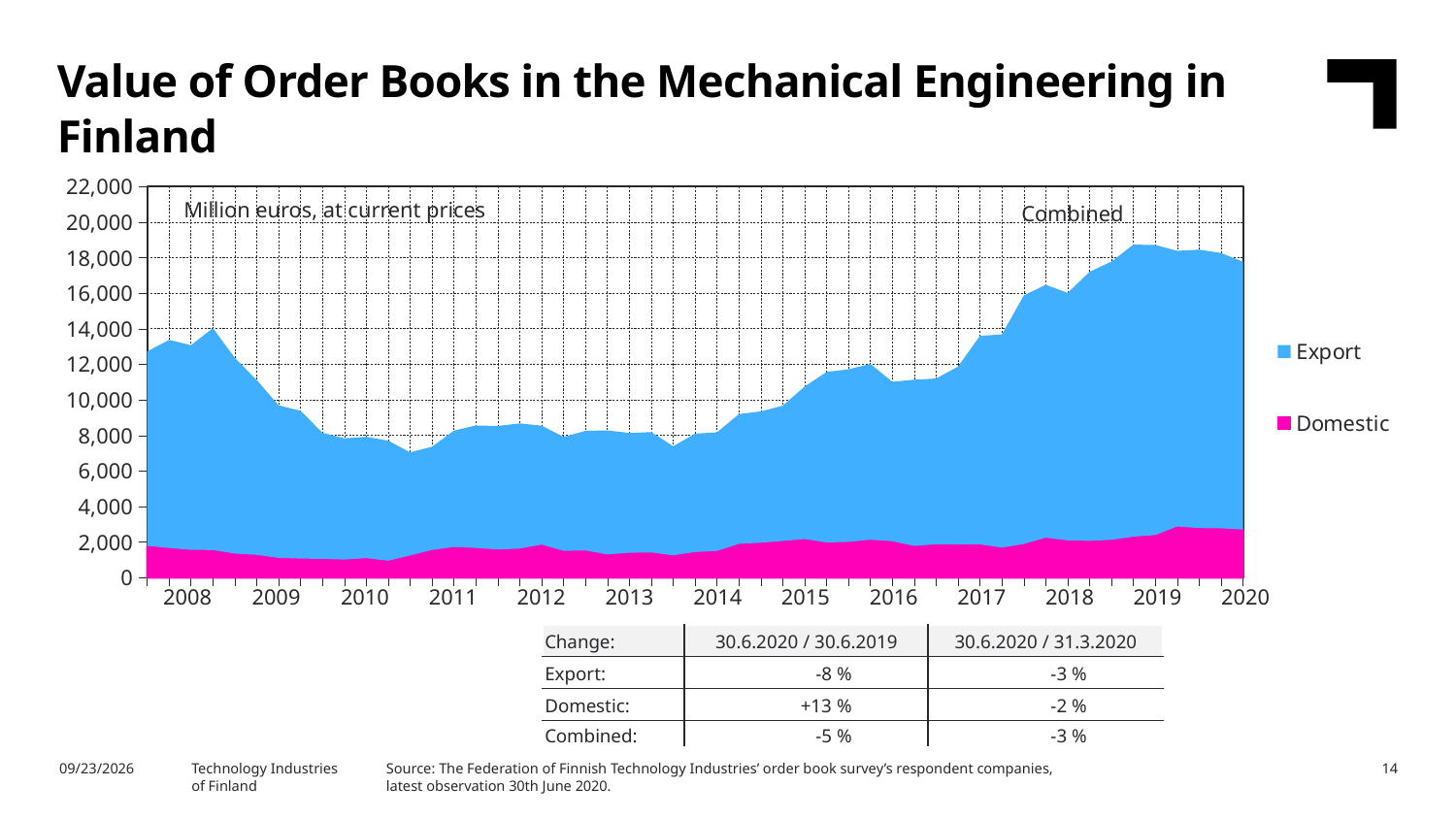
Does the combined value rise or fall between 2008 and 2010? fall Does the combined value rise or fall between 2016 and 2019? rise What kind of chart is shown on the slide? Stacked area chart Which series, Export or Domestic, has the larger values throughout the chart? Export Which two series are listed in the chart legend? Export and Domestic In which labelled year does the combined value reach its highest point? 2019 How many years are labelled on the x axis of the chart? 13 How many series does the chart legend list? 2 What unit note is printed inside the chart area? Million euros, at current prices Is the Domestic value at any point greater or less than 4,000? less Is the combined value at the 2019 peak greater or less than 16,000? greater Is the combined value in 2013 greater or less than 10,000? less